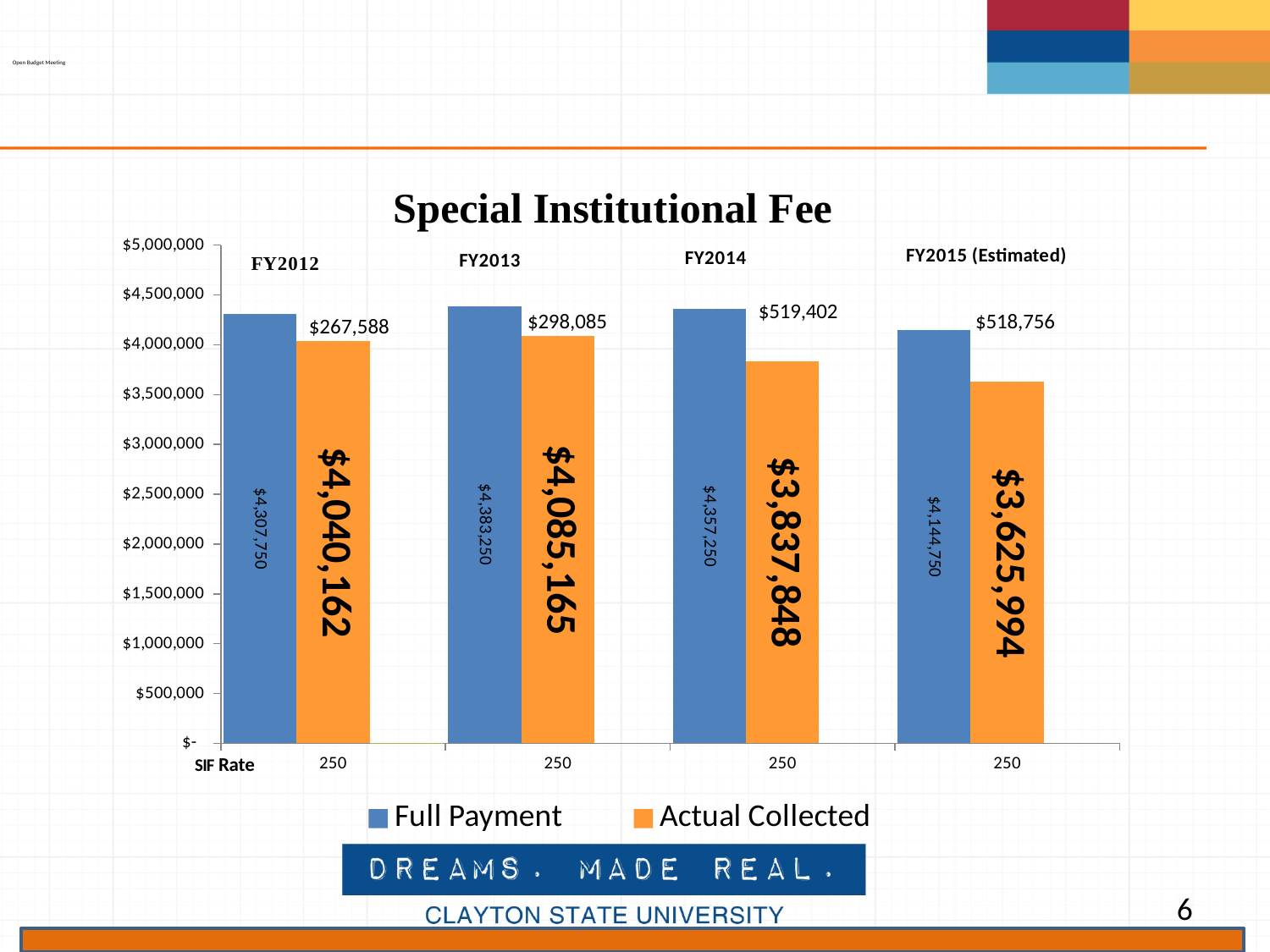
How many series does the chart legend list? 2 Which is larger in FY2013: Full Payment or Actual Collected? Full Payment What is the Actual Collected value for FY2014? $3,837,848 What type of chart is shown on the slide? bar chart Which fiscal year has the highest Full Payment value? FY2013 Which fiscal year has the lowest Actual Collected value? FY2015 (Estimated) What is the difference between Full Payment and Actual Collected in FY2014? $519,402 How many fiscal years are shown in the chart? 4 What is the Actual Collected value for FY2015 (Estimated)? $3,625,994 Does the Actual Collected value rise or fall from FY2013 to FY2015 (Estimated)? fall What is the title of the chart? Special Institutional Fee What is the Full Payment value for FY2012? $4,307,750